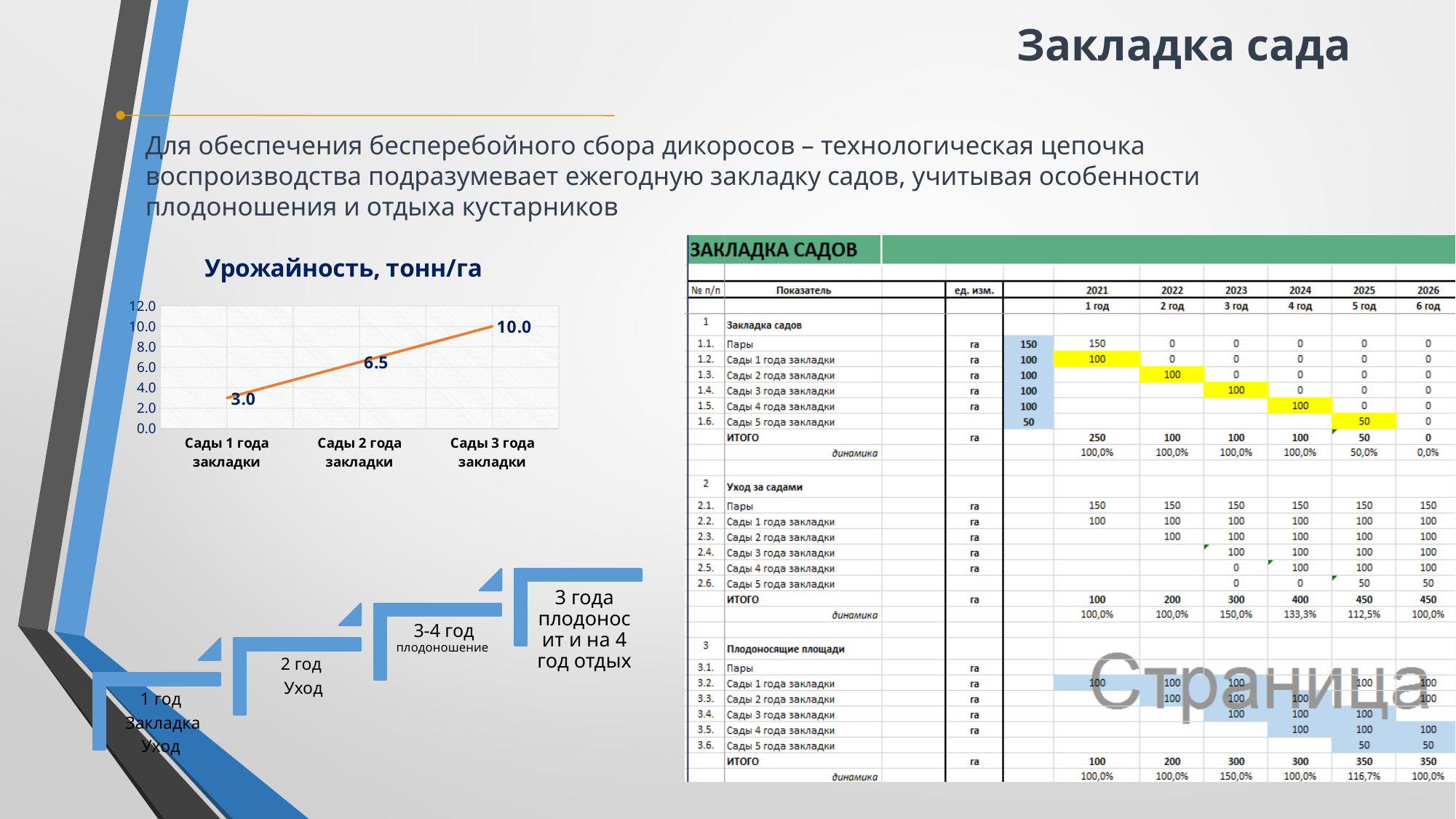
In the chart "Урожайность, тонн/га", what is the value for "Сады 1 года закладки"? 3.0 In the chart "Урожайность, тонн/га", what is the difference between the values for "Сады 3 года закладки" and "Сады 1 года закладки"? 7.0 In the chart "Урожайность, тонн/га", what is the value for "Сады 3 года закладки"? 10.0 In the chart "Урожайность, тонн/га", which category has the highest value? Сады 3 года закладки In the chart "Урожайность, тонн/га", which category has the lowest value? Сады 1 года закладки How many categories are plotted in the chart "Урожайность, тонн/га"? 3 In the chart "Урожайность, тонн/га", which is larger: the value for "Сады 2 года закладки" or "Сады 3 года закладки"? Сады 3 года закладки In the chart "Урожайность, тонн/га", what is the difference between the values for "Сады 2 года закладки" and "Сады 1 года закладки"? 3.5 In the chart "Урожайность, тонн/га", do the values rise or fall from left to right along the x axis? rise What type of chart is "Урожайность, тонн/га"? line chart In the chart "Урожайность, тонн/га", what is the value for "Сады 2 года закладки"? 6.5 In the chart "Урожайность, тонн/га", is the value for "Сады 2 года закладки" greater or less than 8.0? less